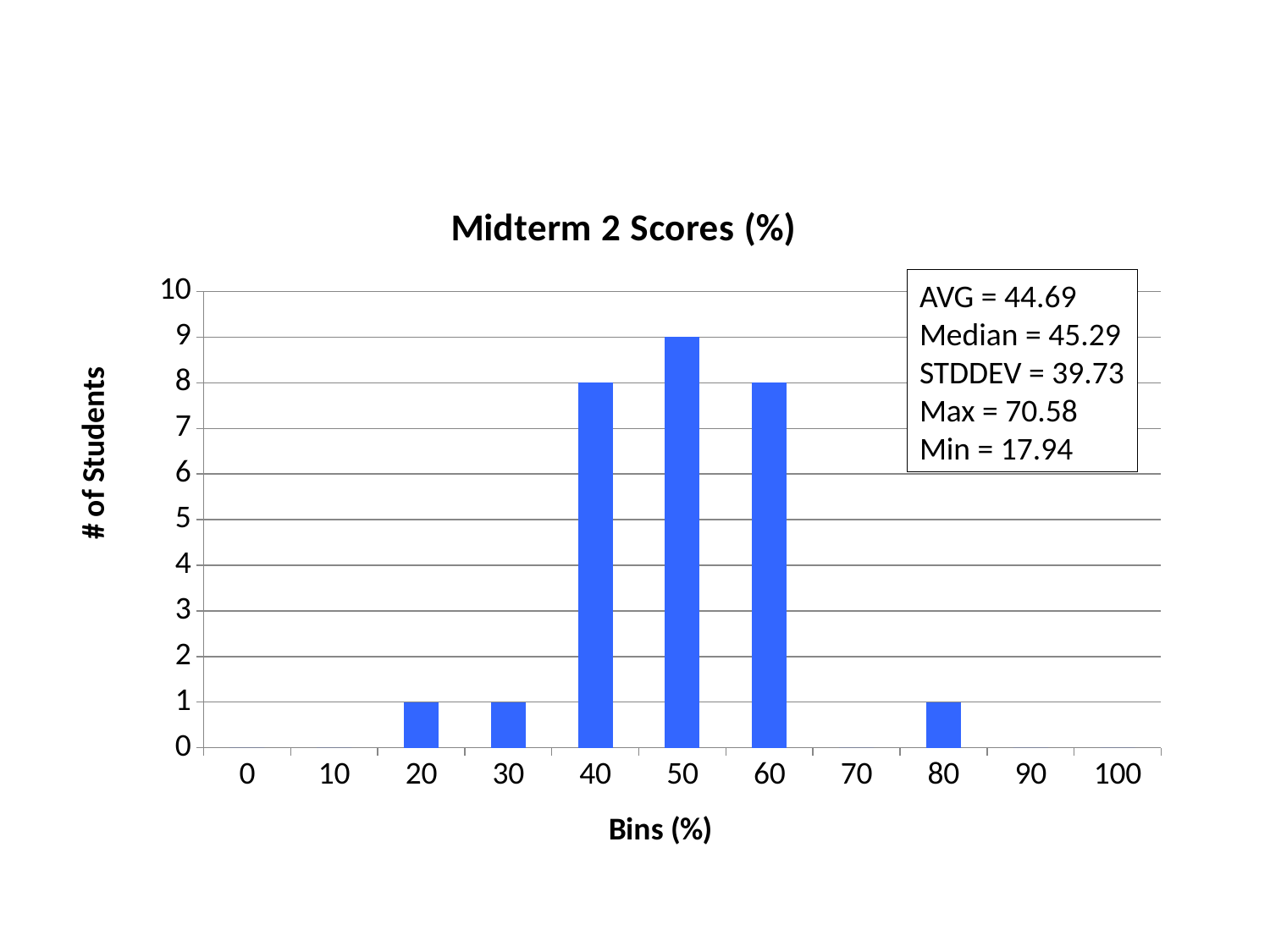
What is the title of the chart? Midterm 2 Scores (%) What kind of chart is shown on the slide? bar chart Is the value for the 60 bin greater or less than 5? greater How many students are in the 50 bin? 9 How many bins are labelled on the x axis? 11 Which bin has the highest number of students? 50 What is the label of the y axis? # of Students What is the difference in number of students between the 50 bin and the 60 bin? 1 How many students are in the 20 bin? 1 How many students are in the 40 bin? 8 Which bin has more students, 40 or 30? 40 How many students are in the 80 bin? 1